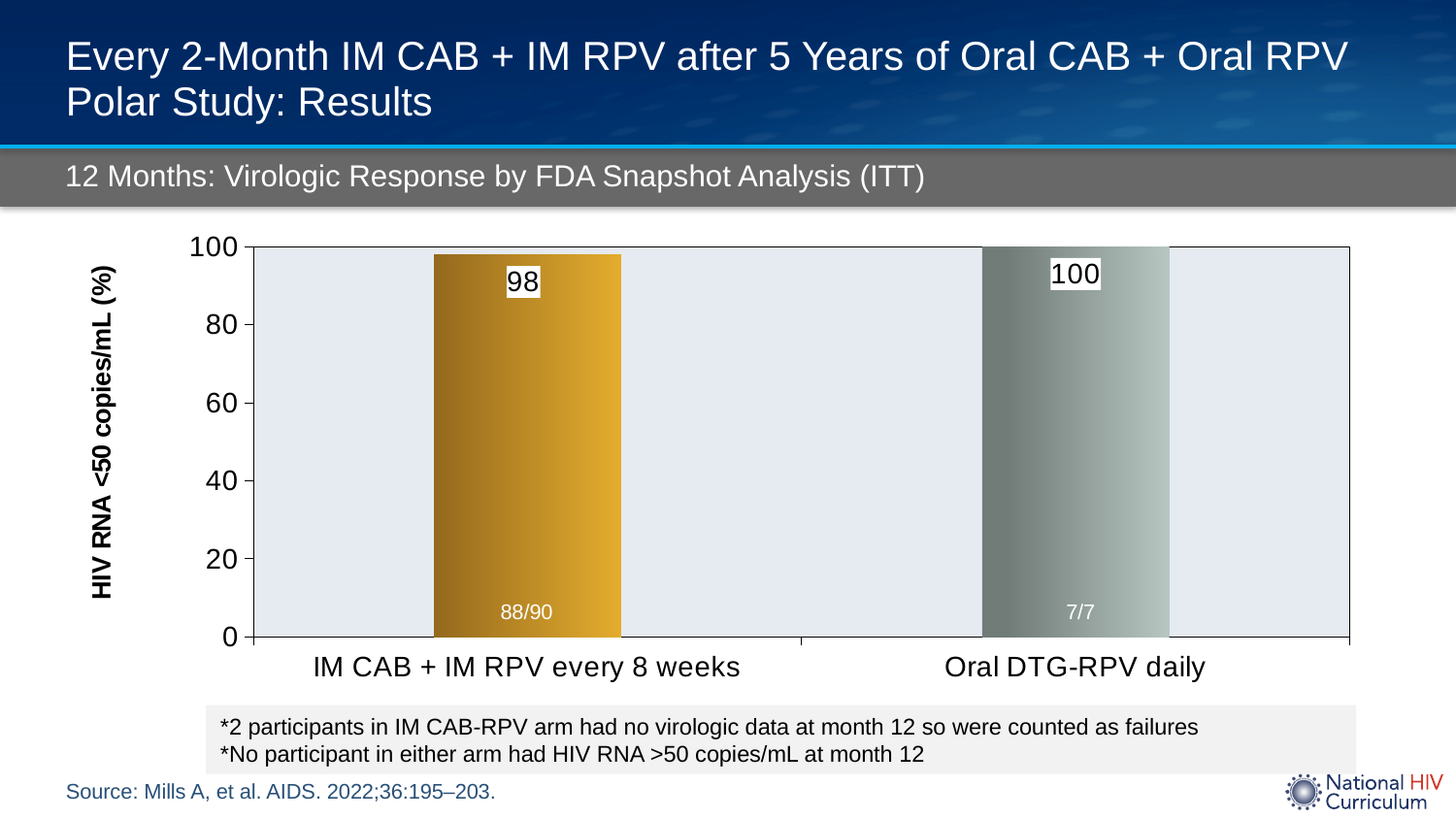
What type of chart is shown on the slide? Bar chart Is the value for the IM CAB + IM RPV every 8 weeks arm greater or less than 80? greater What is the difference in percentage points between the Oral DTG-RPV daily arm and the IM CAB + IM RPV every 8 weeks arm? 2 What is the percentage of participants with HIV RNA <50 copies/mL in the Oral DTG-RPV daily arm? 100 How many participants out of the total achieved HIV RNA <50 copies/mL in the IM CAB + IM RPV every 8 weeks arm? 88/90 Which arm has the lower virologic response rate? IM CAB + IM RPV every 8 weeks What is the label of the y-axis? HIV RNA <50 copies/mL (%) What is the percentage of participants with HIV RNA <50 copies/mL in the IM CAB + IM RPV every 8 weeks arm? 98 How many participants out of the total achieved HIV RNA <50 copies/mL in the Oral DTG-RPV daily arm? 7/7 Which arm has the higher virologic response rate? Oral DTG-RPV daily What is the title of the chart? 12 Months: Virologic Response by FDA Snapshot Analysis (ITT) How many treatment arms are shown in the chart? 2